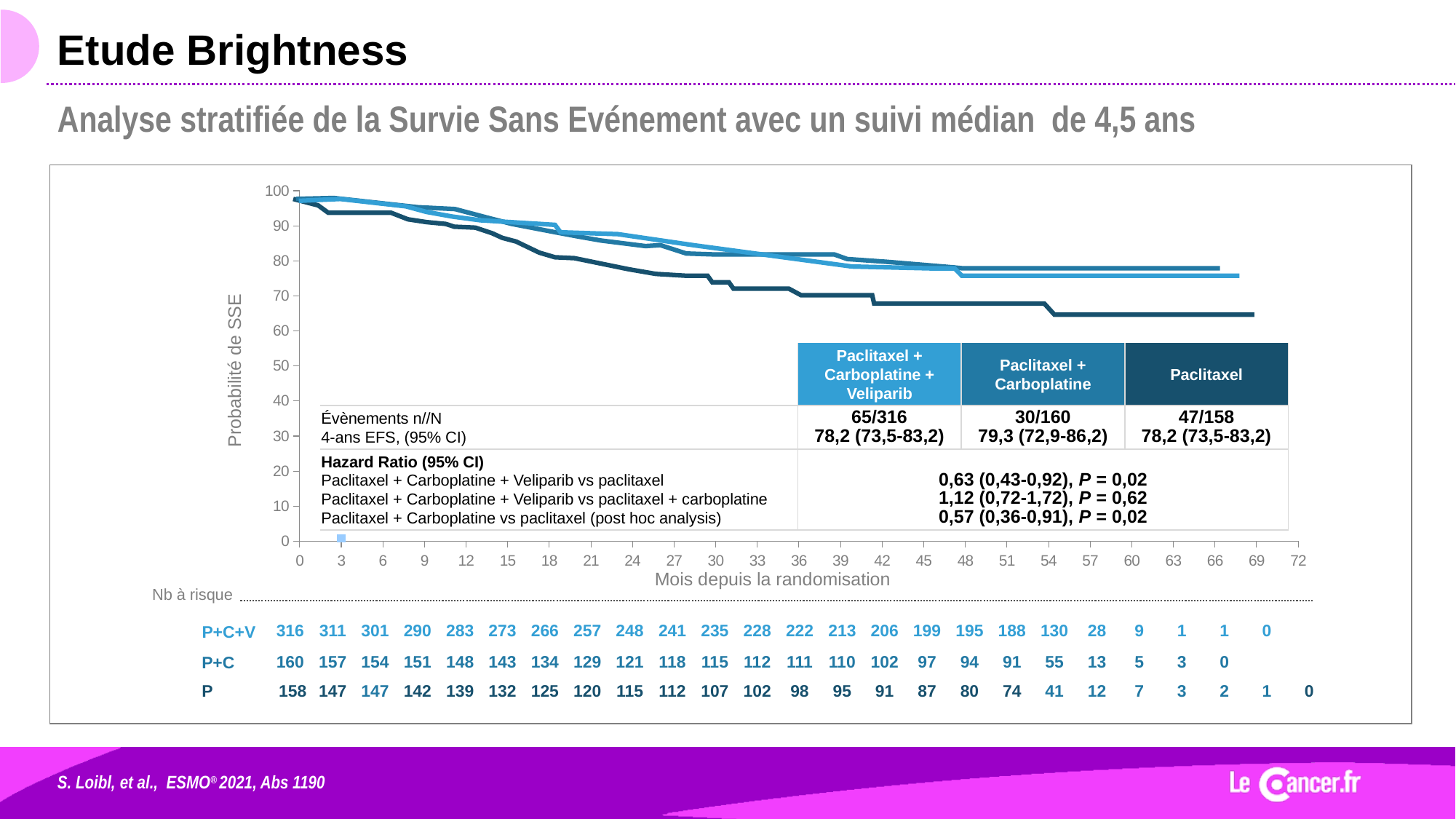
What is the difference between the number at risk at month 0 in the P+C+V group and in the P group? 158 In the number-at-risk table, how many patients are at risk in the P+C group at month 24? 121 What is the label of the x axis? Mois depuis la randomisation What is the hazard ratio (95% CI) for Paclitaxel + Carboplatine + Veliparib vs paclitaxel? 0,63 (0,43-0,92) In the number-at-risk table, how many patients are at risk in the P+C+V group at month 0? 316 What kind of chart is shown on the slide? line chart How many treatment groups are plotted as curves on the chart? 3 What is the label of the y axis? Probabilité de SSE At month 36, which curve is higher: Paclitaxel + Carboplatine + Veliparib or Paclitaxel? Paclitaxel + Carboplatine + Veliparib What is the number of events n/N for the Paclitaxel group? 47/158 Is the Paclitaxel curve at month 60 greater or less than 70? less What is the 4-year EFS (95% CI) for the Paclitaxel + Carboplatine group? 79,3 (72,9-86,2)